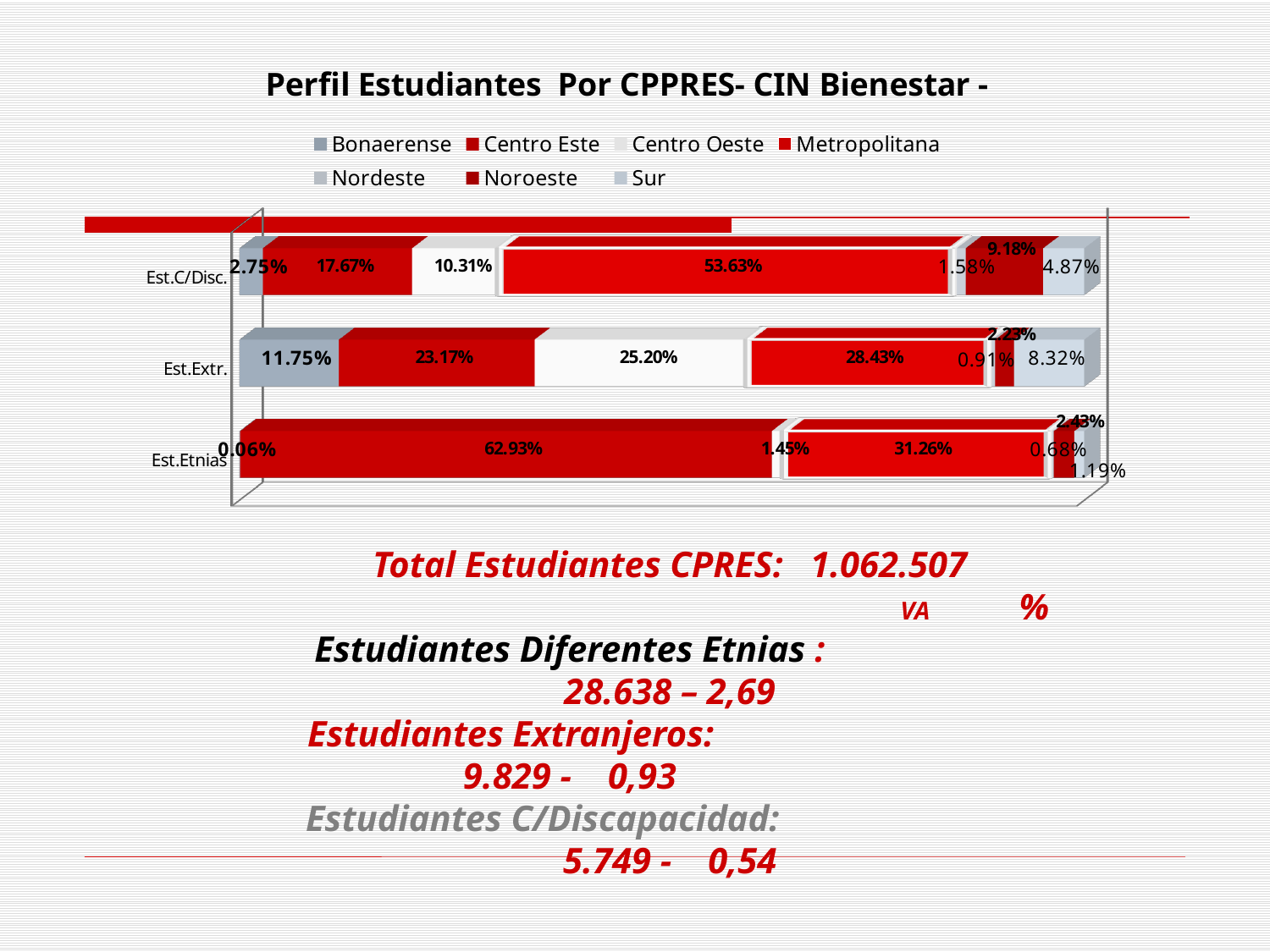
Which is larger for Est.Extr.: the Centro Este value or the Metropolitana value? Metropolitana What is the title of the chart? Perfil Estudiantes Por CPPRES- CIN Bienestar - What is the difference between the Metropolitana values for Est.C/Disc. and Est.Extr.? 25.20% Which category has the highest Centro Este value? Est.Etnias What kind of chart is shown on the slide? stacked bar chart What is the Centro Este value for Est.Etnias? 62.93% What is the Bonaerense value for Est.Extr.? 11.75% How many series does the legend list? 7 What is the Metropolitana value for Est.C/Disc.? 53.63% Which category has the lowest Bonaerense value? Est.Etnias What is the Centro Oeste value for Est.Extr.? 25.20% How many categories are plotted on the chart? 3